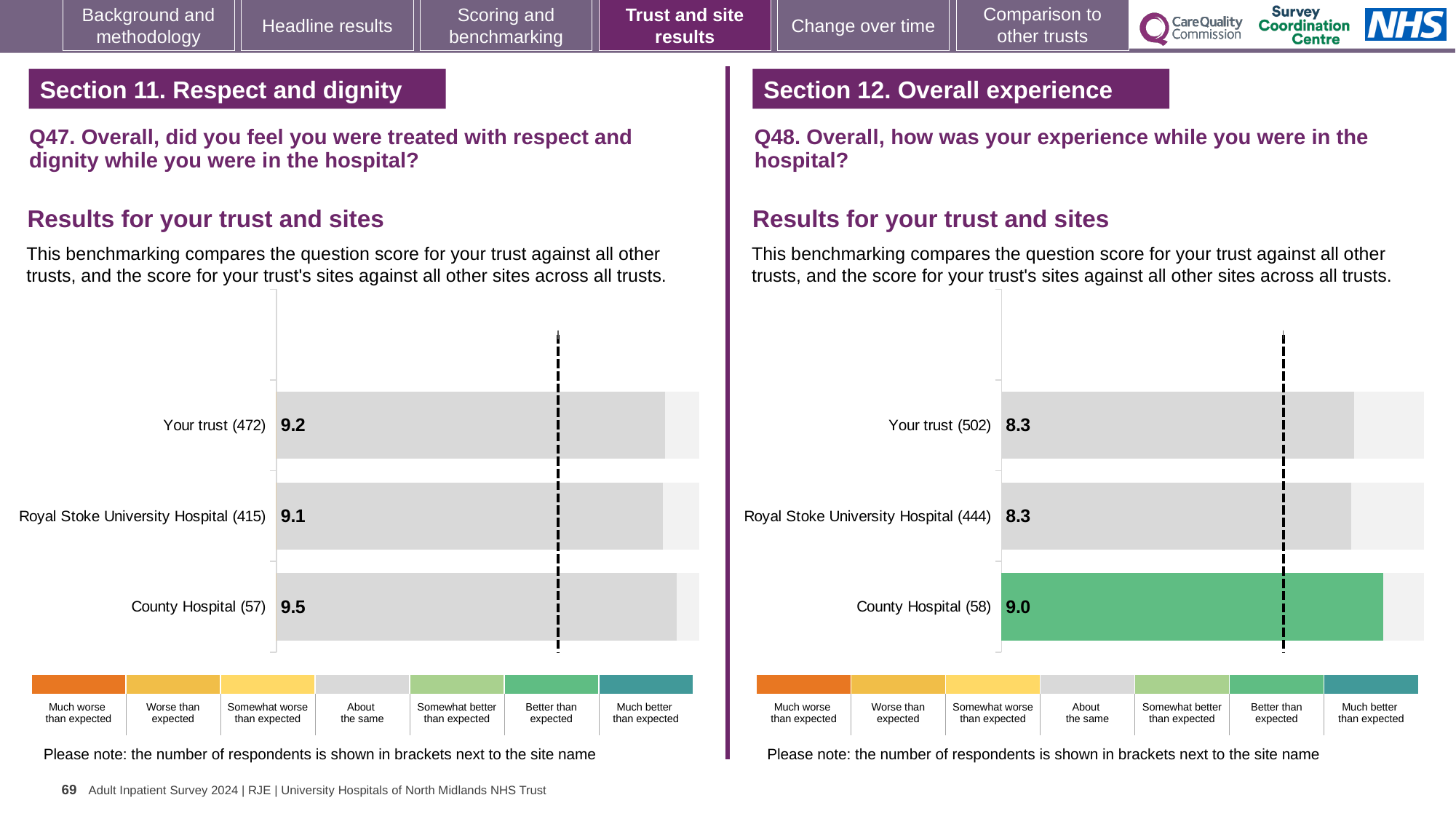
On the Q48 chart (Section 12. Overall experience), what is the difference between the County Hospital score and the Your trust score? 0.7 On the Q47 chart (Section 11. Respect and dignity), what is the score for Your trust? 9.2 What type of chart is used on the Q48 chart (Section 12. Overall experience)? Bar chart On the Q48 chart (Section 12. Overall experience), how many respondents are shown in brackets for Royal Stoke University Hospital? 444 On the Q48 chart (Section 12. Overall experience), which site or trust has the highest score? County Hospital On the Q48 chart (Section 12. Overall experience), what is the score for County Hospital? 9.0 On the Q47 chart (Section 11. Respect and dignity), what is the score for Royal Stoke University Hospital? 9.1 On the Q47 chart (Section 11. Respect and dignity), what is the difference between the County Hospital score and the Royal Stoke University Hospital score? 0.4 How many bars are plotted on the Q47 chart (Section 11. Respect and dignity)? 3 On the Q48 chart (Section 12. Overall experience), what is the score for Your trust? 8.3 On the Q47 chart (Section 11. Respect and dignity), what is the score for County Hospital? 9.5 On the Q47 chart (Section 11. Respect and dignity), which site or trust has the highest score? County Hospital